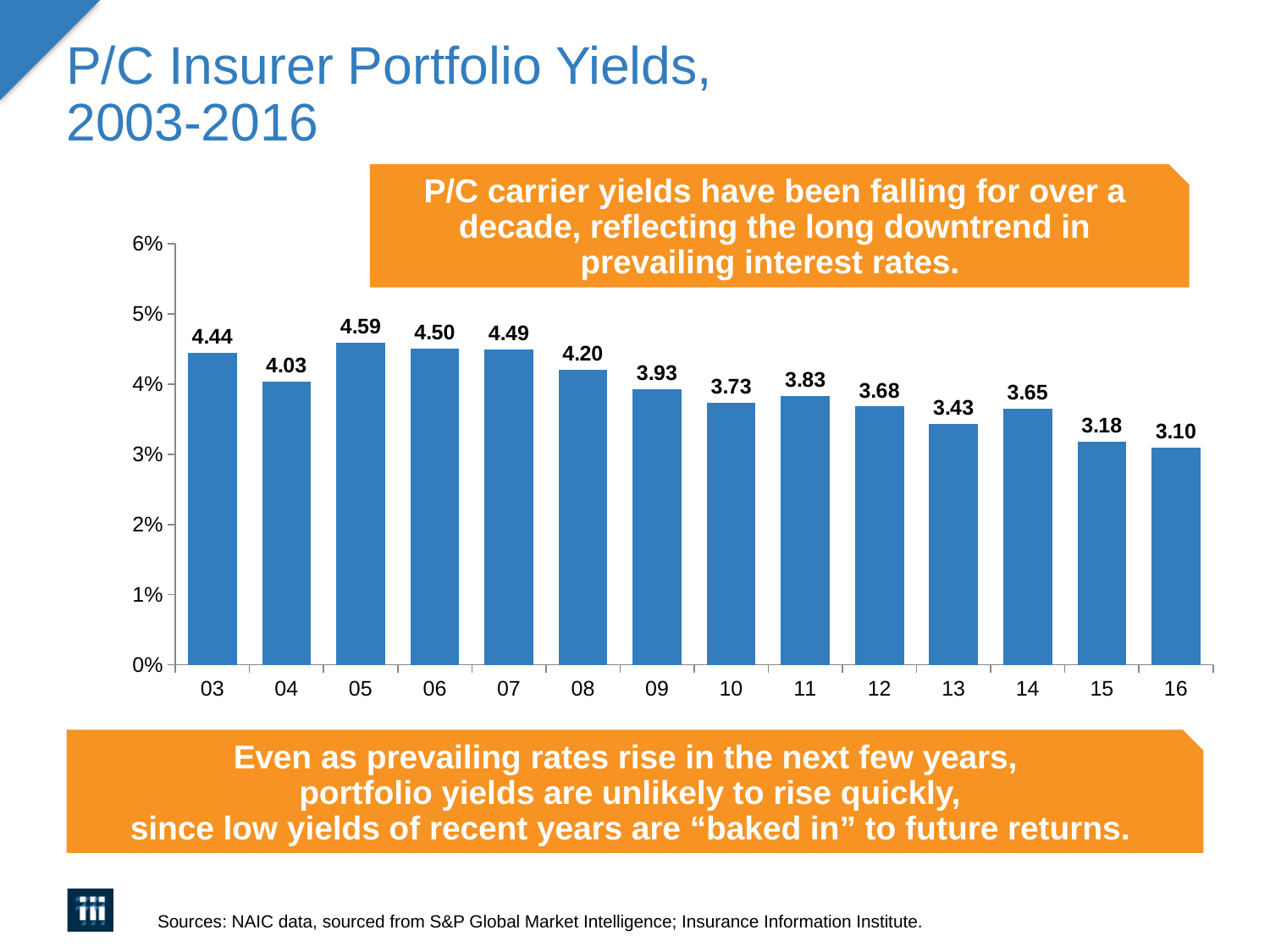
Which year has the highest portfolio yield? 05 What kind of chart is shown on the slide? bar chart How many years are shown on the x axis? 14 What is the portfolio yield value shown for 2016? 3.10 What is the portfolio yield value shown for 2011? 3.83 Do the portfolio yields generally rise or fall from 2003 to 2016? fall What is the title of the chart? P/C Insurer Portfolio Yields, 2003-2016 Which year has the lowest portfolio yield? 16 What is the difference between the 2003 value and the 2016 value? 1.34 What is the portfolio yield value shown for 2005? 4.59 Is the value for 2013 greater or less than 4%? less Which is larger, the value for 2010 or the value for 2011? 2011